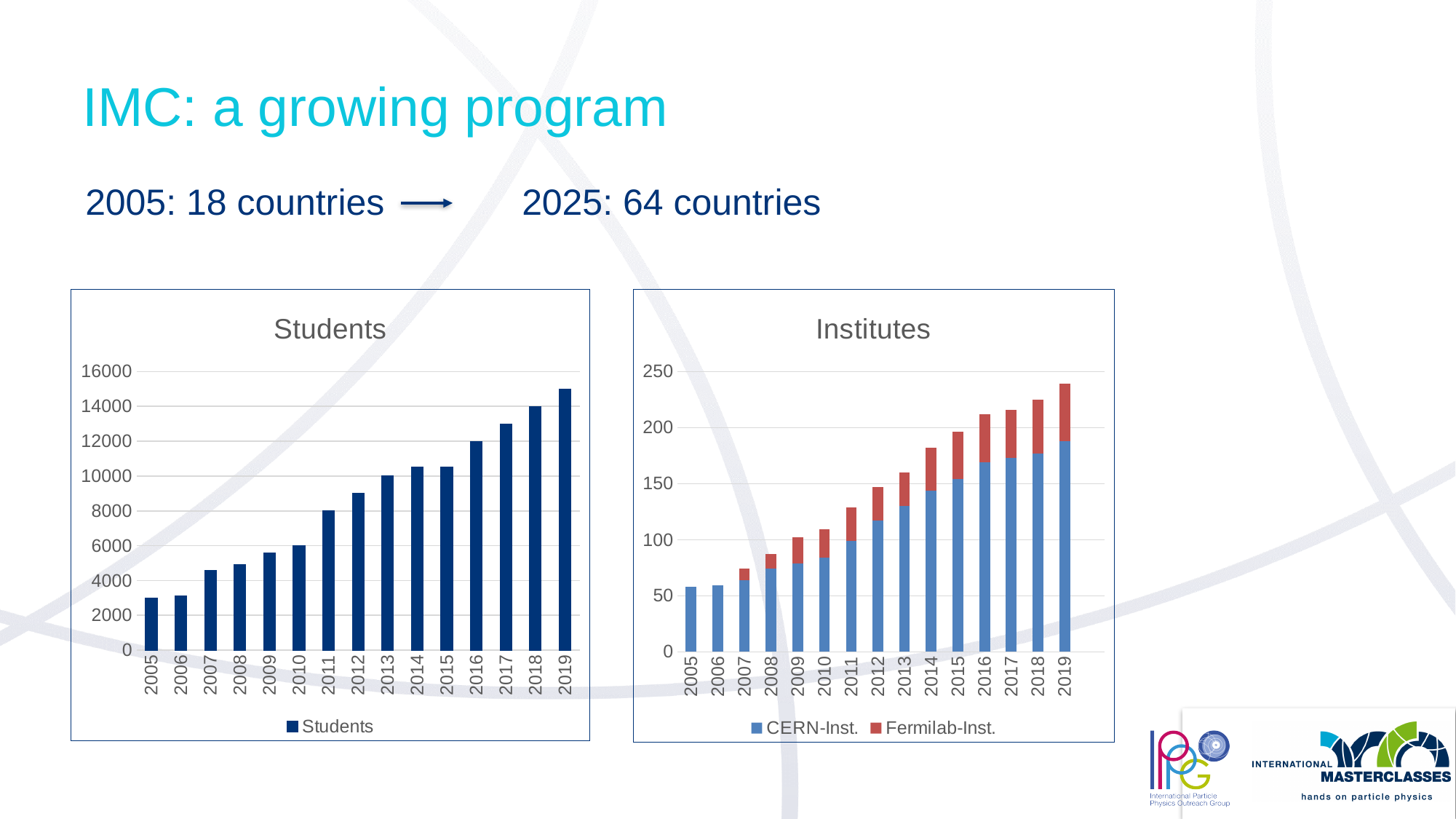
What are the two series named in the legend of the Institutes chart? CERN-Inst. and Fermilab-Inst. How many series does the legend of the Institutes chart list? 2 In the Institutes chart, which year has the tallest stacked bar? 2019 In the Students chart, which year has more students, 2013 or 2017? 2017 How many years are shown on the x axis of the Students chart? 15 In the Institutes chart, is the total for 2019 greater or less than 200? greater What kind of chart is the Students chart? bar chart In the Students chart, which year has the highest number of students? 2019 In the Students chart, do the values generally rise or fall from 2005 to 2019? rise In the Students chart, is the value for 2005 greater or less than 4000? less In the Students chart, is the value for 2019 greater or less than 14000? greater In the Institutes chart, which series is larger in 2019, CERN-Inst. or Fermilab-Inst.? CERN-Inst.